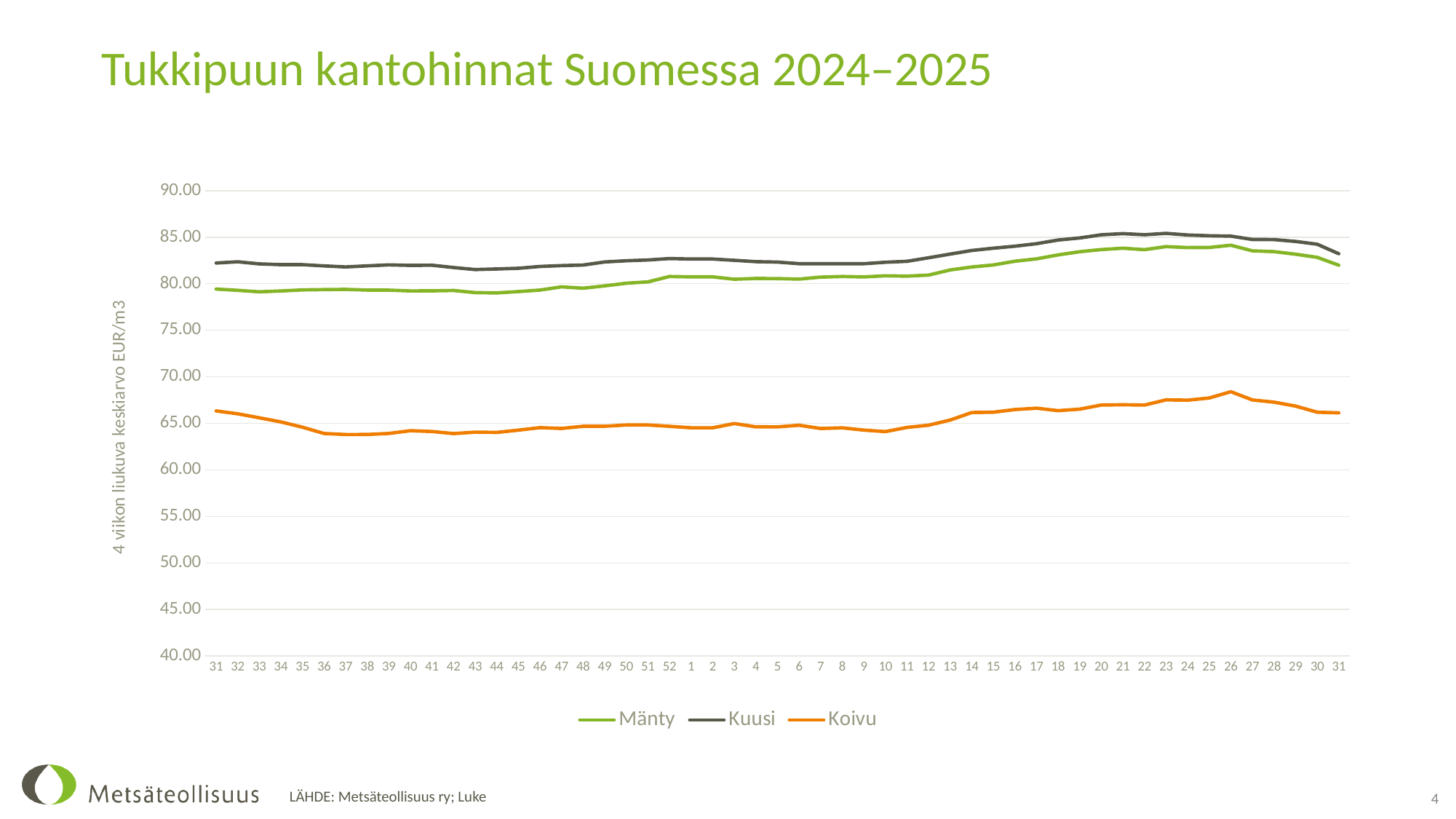
Is the value for Koivu at week 36 greater or less than 65.00? less Which is larger at week 31 (the last point): the value for Kuusi or the value for Koivu? Kuusi How many series does the legend list? 3 Is the value for Mänty at week 44 greater or less than 80.00? less How many points are plotted along the x axis for each series? 53 Which series has the lowest values throughout the chart? Koivu What kind of chart is shown on the slide? line chart What is the title of the chart? Tukkipuun kantohinnat Suomessa 2024–2025 Which series has the highest values throughout the chart? Kuusi Is the value for Mänty at week 26 greater or less than 80.00? greater Which series are listed in the legend? Mänty, Kuusi, Koivu